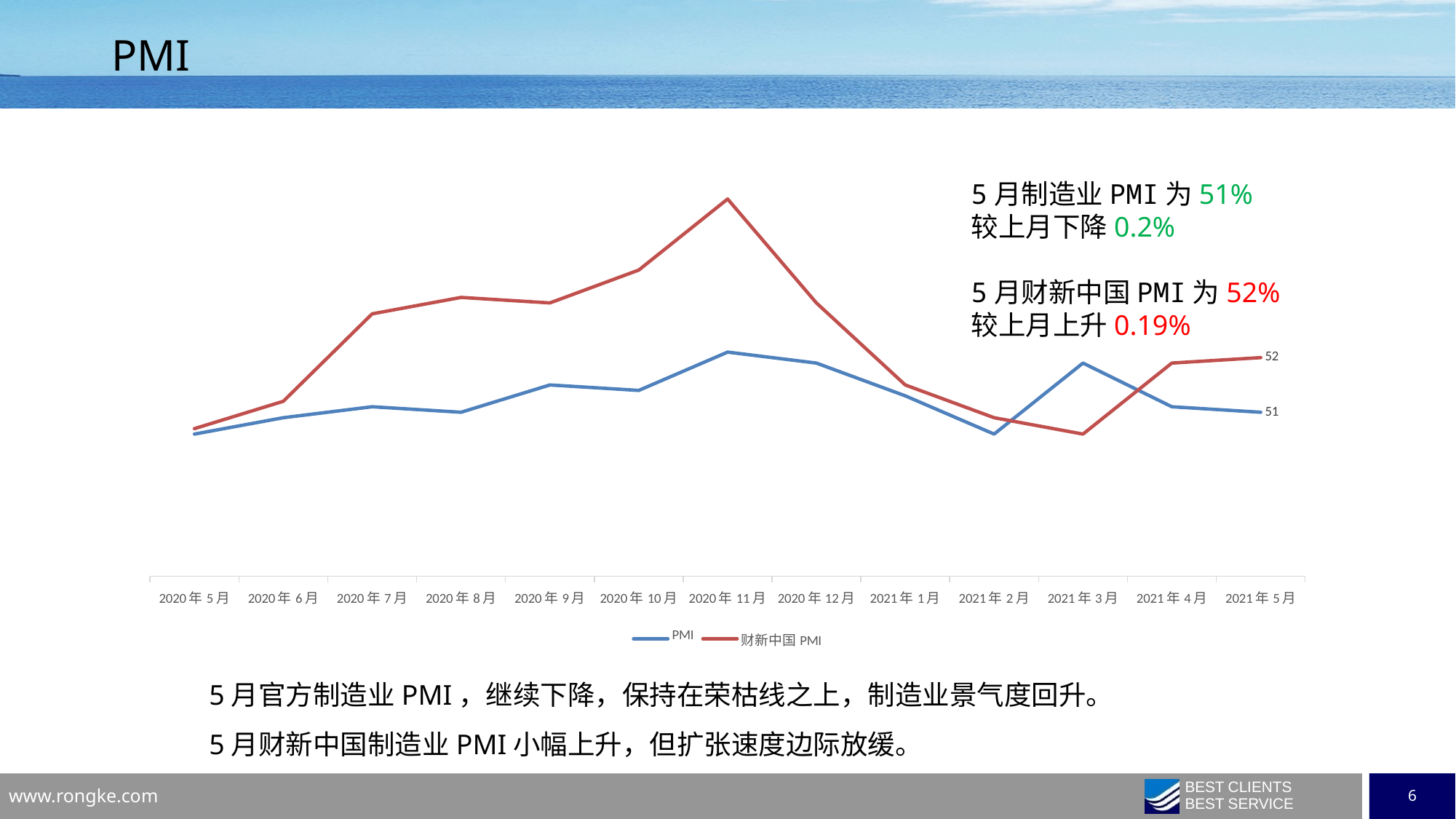
What is the difference between the 财新中国 PMI and PMI values at 2021年5月? 1 What is the value of the 财新中国 PMI series at 2021年5月? 52 How many series does the chart legend list? 2 Does the 财新中国 PMI series rise or fall from 2020年11月 to 2021年3月? fall At 2021年3月, which series is higher, PMI or 财新中国 PMI? PMI What kind of chart is shown on the slide? line chart How many months are plotted along the x axis of the chart? 13 At 2020年11月, which series is higher, PMI or 财新中国 PMI? 财新中国 PMI What colour is the line for the 财新中国 PMI series? red At 2021年5月, which series has the larger value, PMI or 财新中国 PMI? 财新中国 PMI In which month does the 财新中国 PMI series reach its highest value? 2020年11月 What is the value of the PMI series at 2021年5月? 51